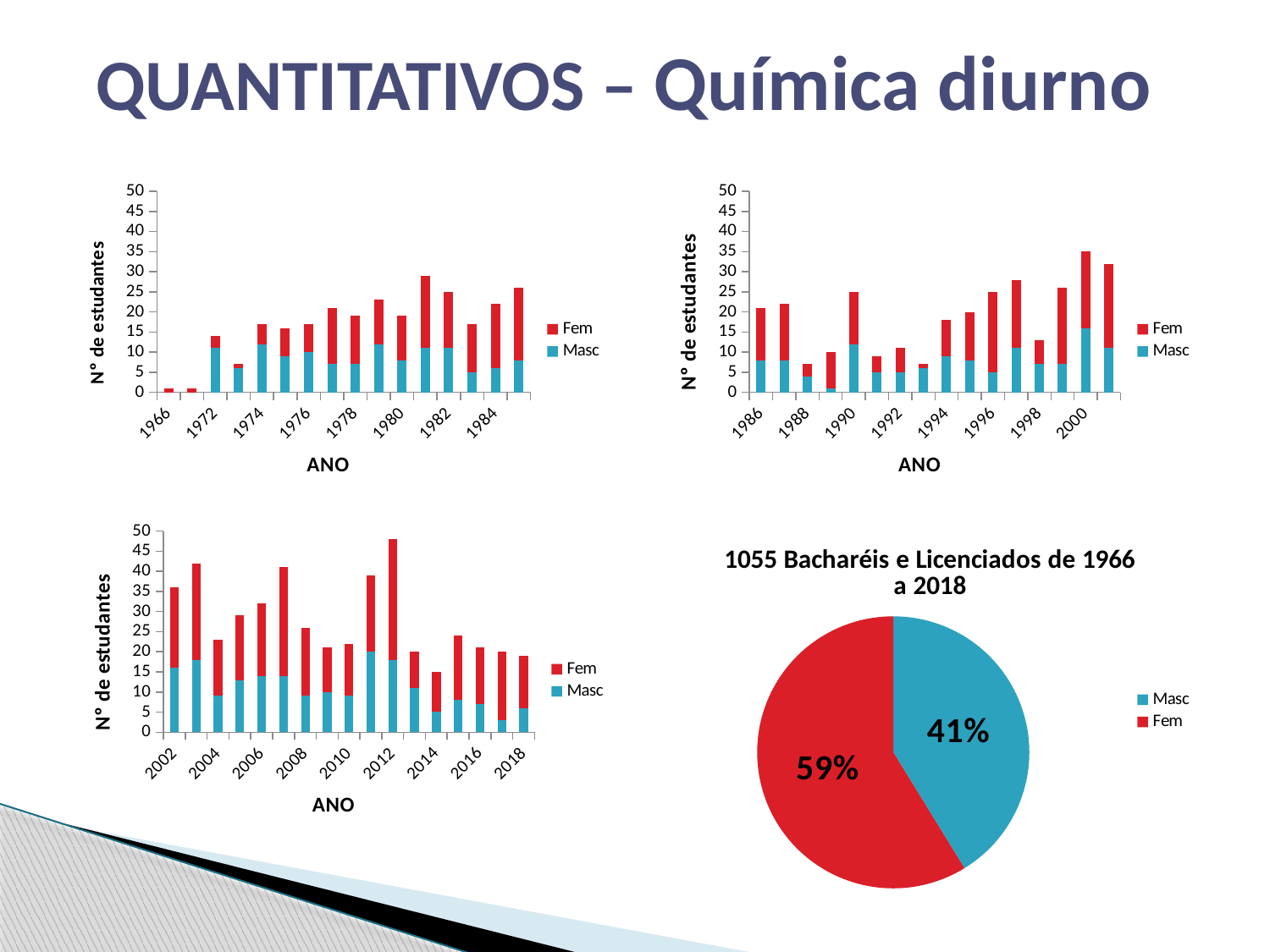
In the top-right bar chart (years 1986 to 2001), is the total value for 2000 greater or less than 30? greater In the top-right bar chart (years 1986 to 2001), is the total value for 1989 greater or less than 15? less In the bottom-left bar chart (years 2002 to 2018), is the total value for 2015 greater or less than 20? greater What kind of chart is the top-left chart on the slide? bar chart In the pie chart at the bottom right, which slice is larger, Masc or Fem? Fem In the bottom-left bar chart (years 2002 to 2018), which year has the highest total number of students? 2012 In the pie chart titled '1055 Bacharéis e Licenciados de 1966 a 2018', what share is Masc? 41% In the pie chart titled '1055 Bacharéis e Licenciados de 1966 a 2018', what share is Fem? 59% In the top-left bar chart (years 1966 to 1985), which year has the highest total number of students? 1981 How many series does the legend of the bottom-left bar chart list? 2 What is the title of the pie chart at the bottom right of the slide? 1055 Bacharéis e Licenciados de 1966 a 2018